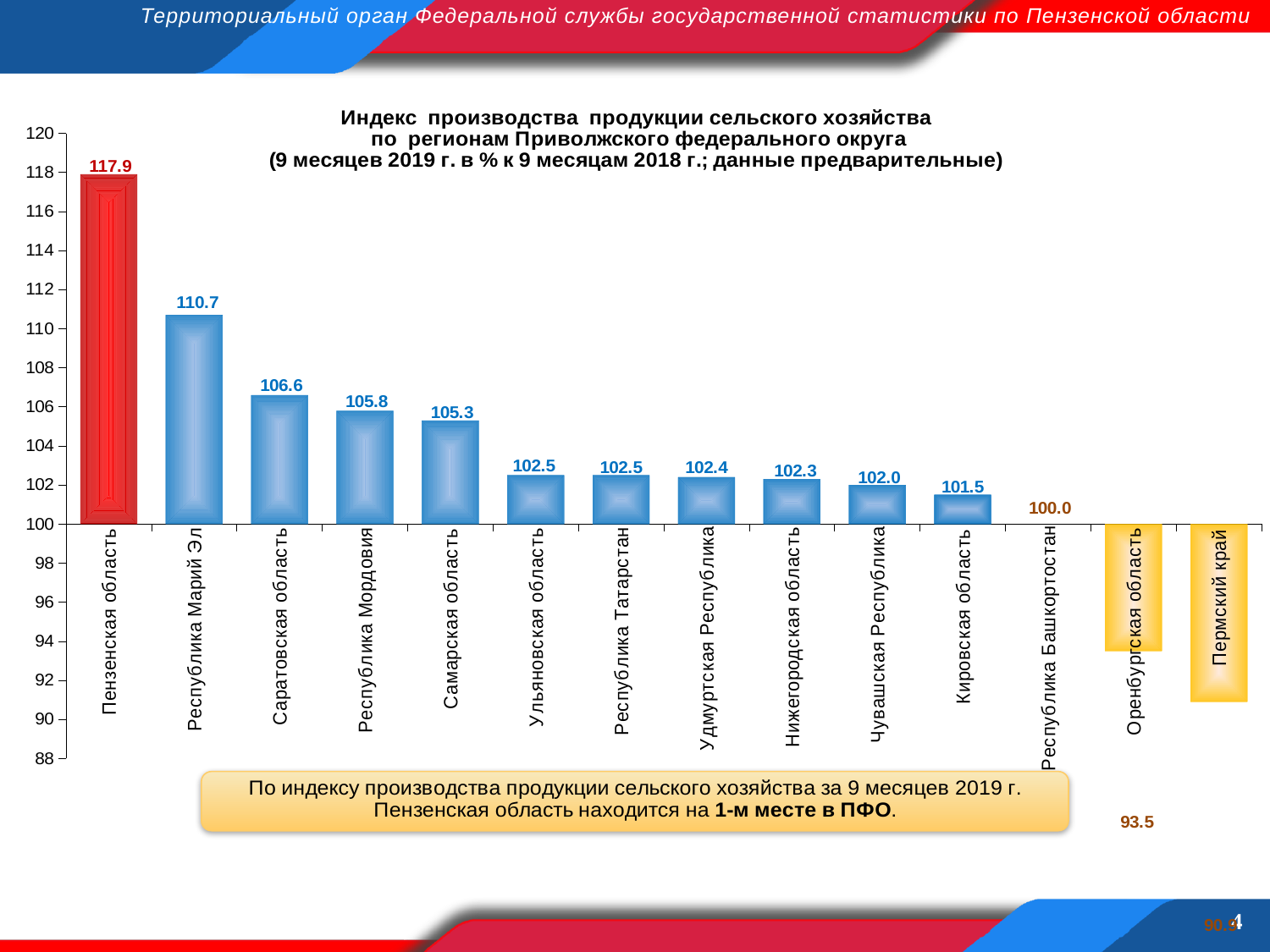
What is the difference between the values for Пензенская область and Республика Марий Эл? 7.2 What type of chart is shown on the slide? bar chart Is the value for Пермский край greater or less than 100? less What is the value for Оренбургская область? 93.5 Which region has the lowest value? Пермский край What is the value for Республика Марий Эл? 110.7 How many regions are shown on the chart? 14 What is the value for Пензенская область? 117.9 Which region has the highest value? Пензенская область Which is larger, the value for Саратовская область or the value for Самарская область? Саратовская область What colour is the bar for Пензенская область? red What is the value for Республика Башкортостан? 100.0